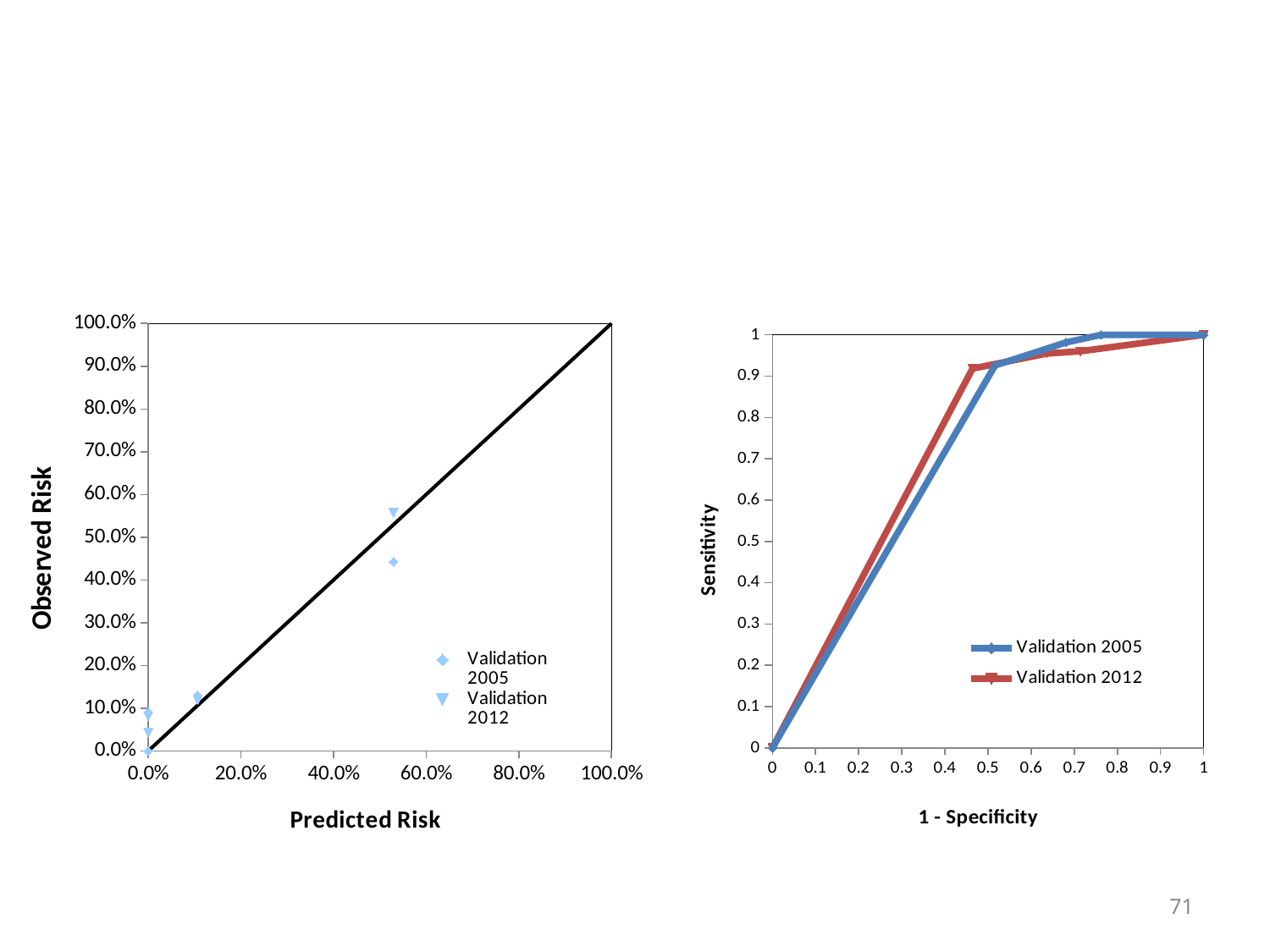
In the right chart, at a 1 - Specificity of 0.3, which series has the higher sensitivity, Validation 2005 or Validation 2012? Validation 2012 How many series does the legend of the right chart list? 2 In the left chart, at a predicted risk of about 53%, which series has the higher observed risk, Validation 2005 or Validation 2012? Validation 2012 What kind of chart is the left chart (Predicted Risk vs Observed Risk)? scatter chart In the right chart, is the sensitivity of Validation 2012 at a 1 - Specificity of about 0.46 greater or less than 0.8? greater In the left chart, is the observed risk for the Validation 2012 point at a predicted risk of about 53% greater or less than 50.0%? greater How many series does the legend of the left chart list? 2 What is the x-axis title of the left chart? Predicted Risk In the right chart, does sensitivity rise or fall as 1 - Specificity increases from 0 to 1? rise What is the y-axis title of the right chart? Sensitivity What kind of chart is the right chart (Sensitivity vs 1 - Specificity)? line chart In the left chart, is the observed risk for the Validation 2005 point at a predicted risk of about 53% greater or less than 50.0%? less